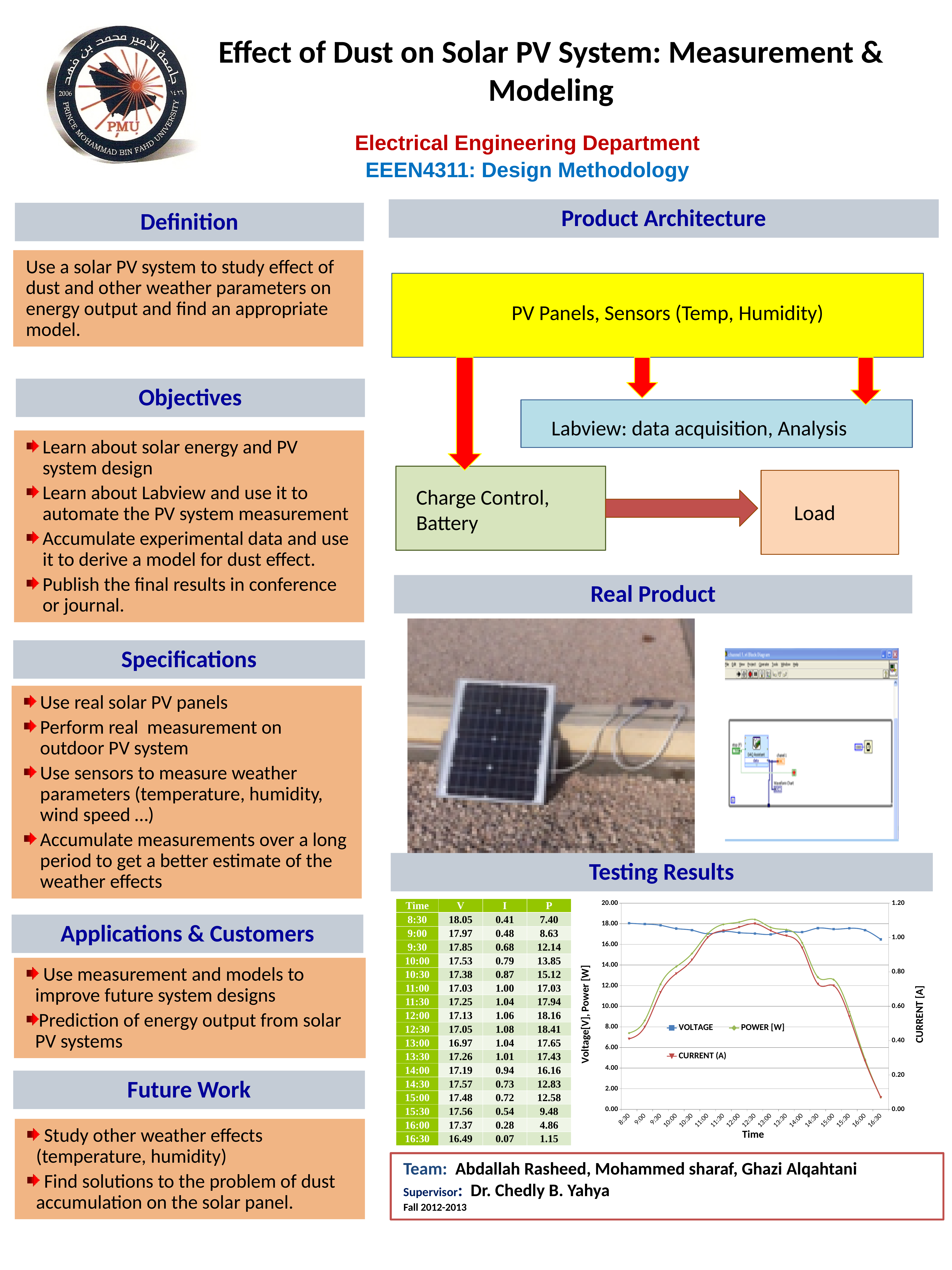
How many time points are plotted along the x axis of the Testing Results chart? 17 In the Testing Results chart, is the POWER [W] value at 16:30 greater or less than 4.00? less What kind of chart is shown under Testing Results? line chart In the Testing Results chart, does the POWER [W] series rise or fall between 13:00 and 16:30? fall In the Testing Results chart, is the VOLTAGE value at 8:30 greater or less than 16.00? greater How many series does the legend of the Testing Results chart list? 3 In the Testing Results chart, which is larger at 16:30: the VOLTAGE value or the POWER [W] value? VOLTAGE In the Testing Results chart, at what time does the POWER [W] series reach its highest value? 12:30 In the Testing Results chart, does the POWER [W] series rise or fall between 8:30 and 12:30? rise What is the title of the right-hand vertical axis of the Testing Results chart? CURRENT [A] In the Testing Results chart, is the CURRENT (A) value at 8:30 greater or less than 0.60 on the right axis? less In the Testing Results chart, at what time is the POWER [W] series lowest? 16:30